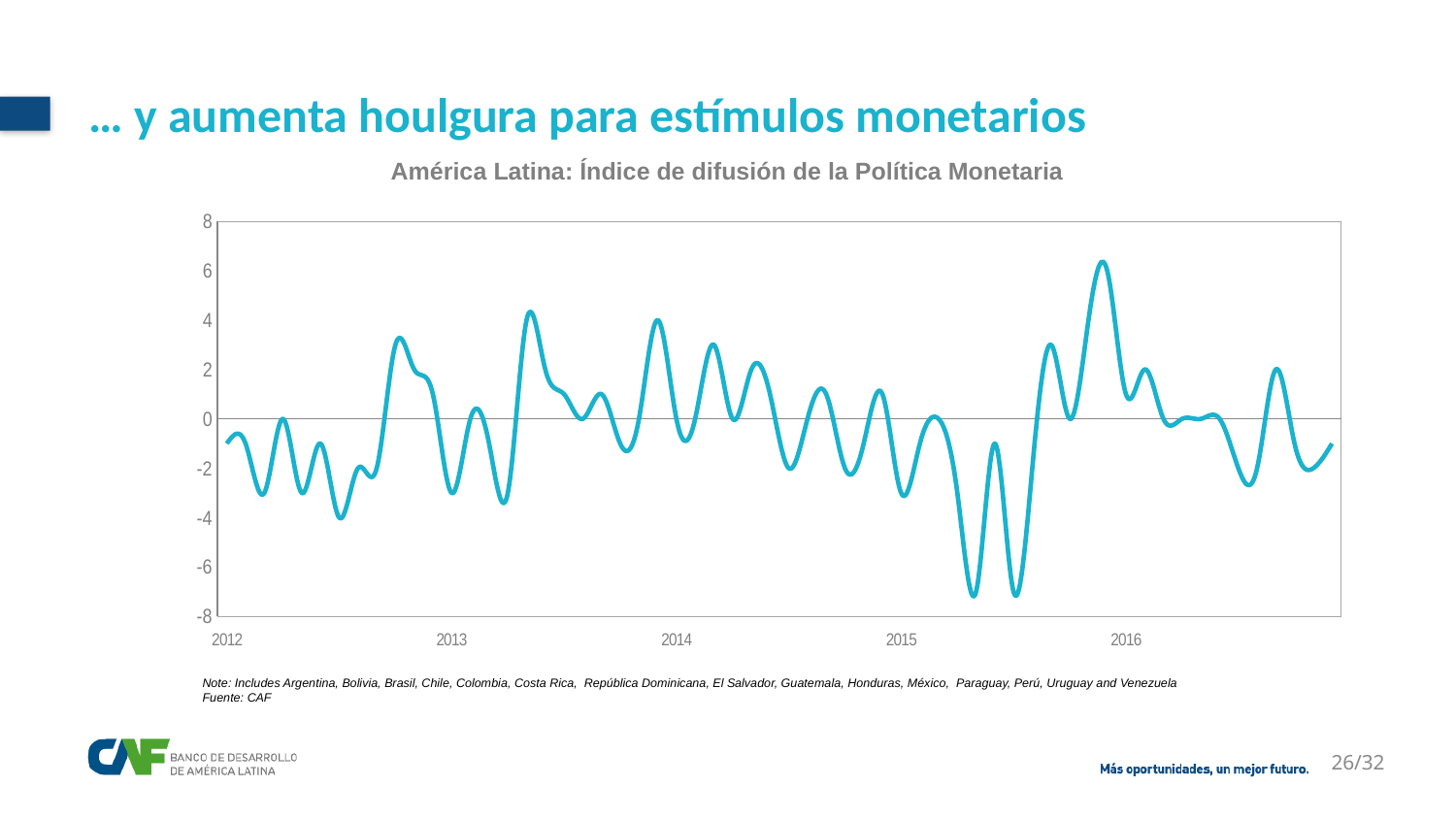
What is the highest value shown on the y axis of the chart? 8 Is the value of the index at the end of the series greater or less than 0? less How many years are labeled on the x axis of the chart? 5 Is the peak of the index in late 2013 greater or less than 2? greater Is the value of the index at the start of 2012 greater or less than 0? less What kind of chart is shown on the slide? line chart Which is larger: the highest peak of the index or the absolute value of its lowest trough? the lowest trough (in absolute value) What is the title of the chart? América Latina: Índice de difusión de la Política Monetaria What is the source (Fuente) cited below the chart? CAF